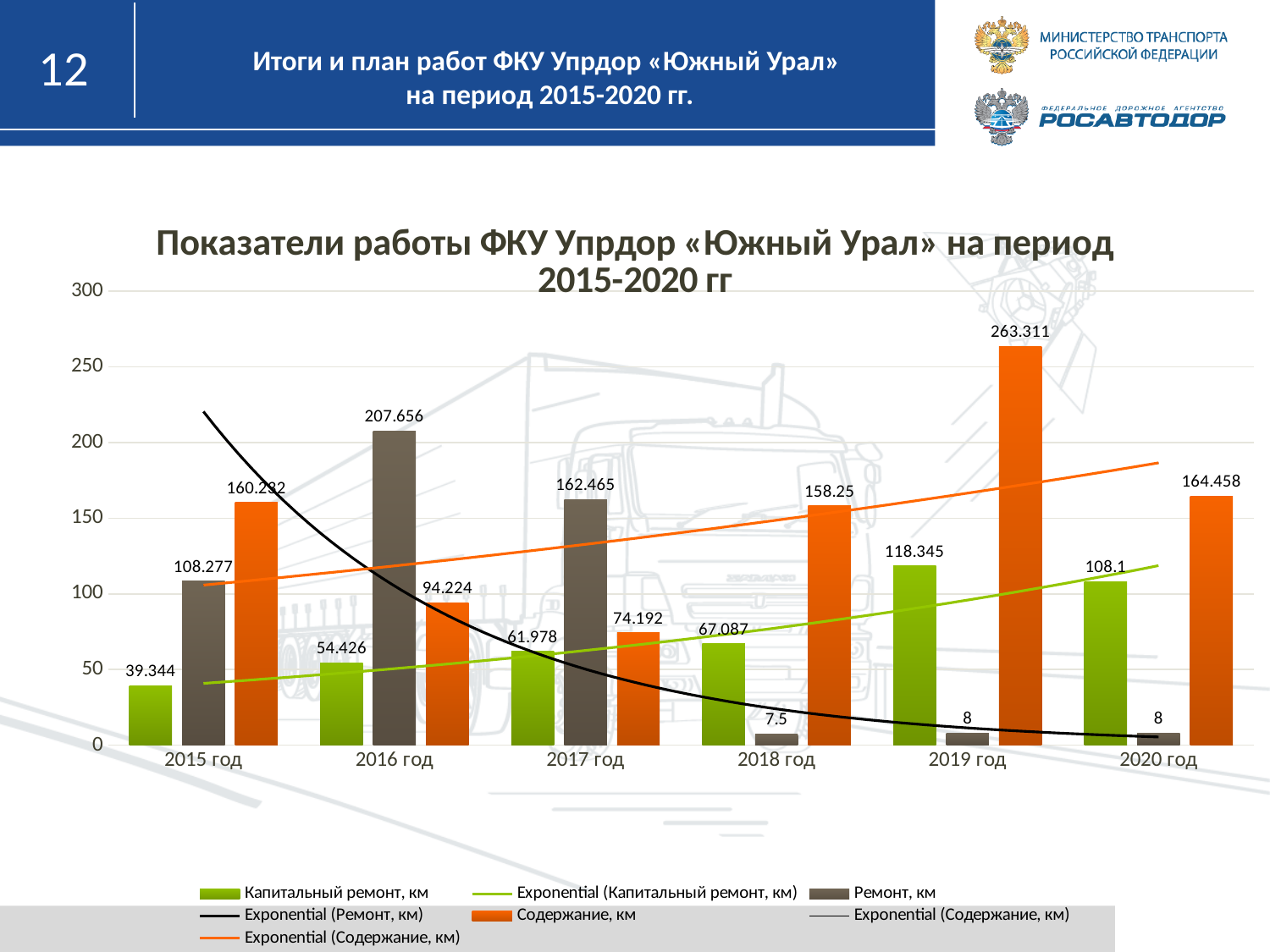
How many entries does the legend list? 7 What kind of chart is this? bar chart What is the value of Капитальный ремонт, км for 2015 год? 39.344 Which is larger in 2017 год: Ремонт, км or Содержание, км? Ремонт, км How many years are shown on the x axis? 6 What is the value of Содержание, км for 2019 год? 263.311 In which year is Содержание, км the highest? 2019 год What is the value of Ремонт, км for 2016 год? 207.656 In which year is Капитальный ремонт, км the lowest? 2015 год Does Ремонт, км rise or fall from 2016 год to 2020 год? fall What is the difference between Ремонт, км in 2016 год and 2017 год? 45.191 What is the value of Ремонт, км for 2020 год? 8